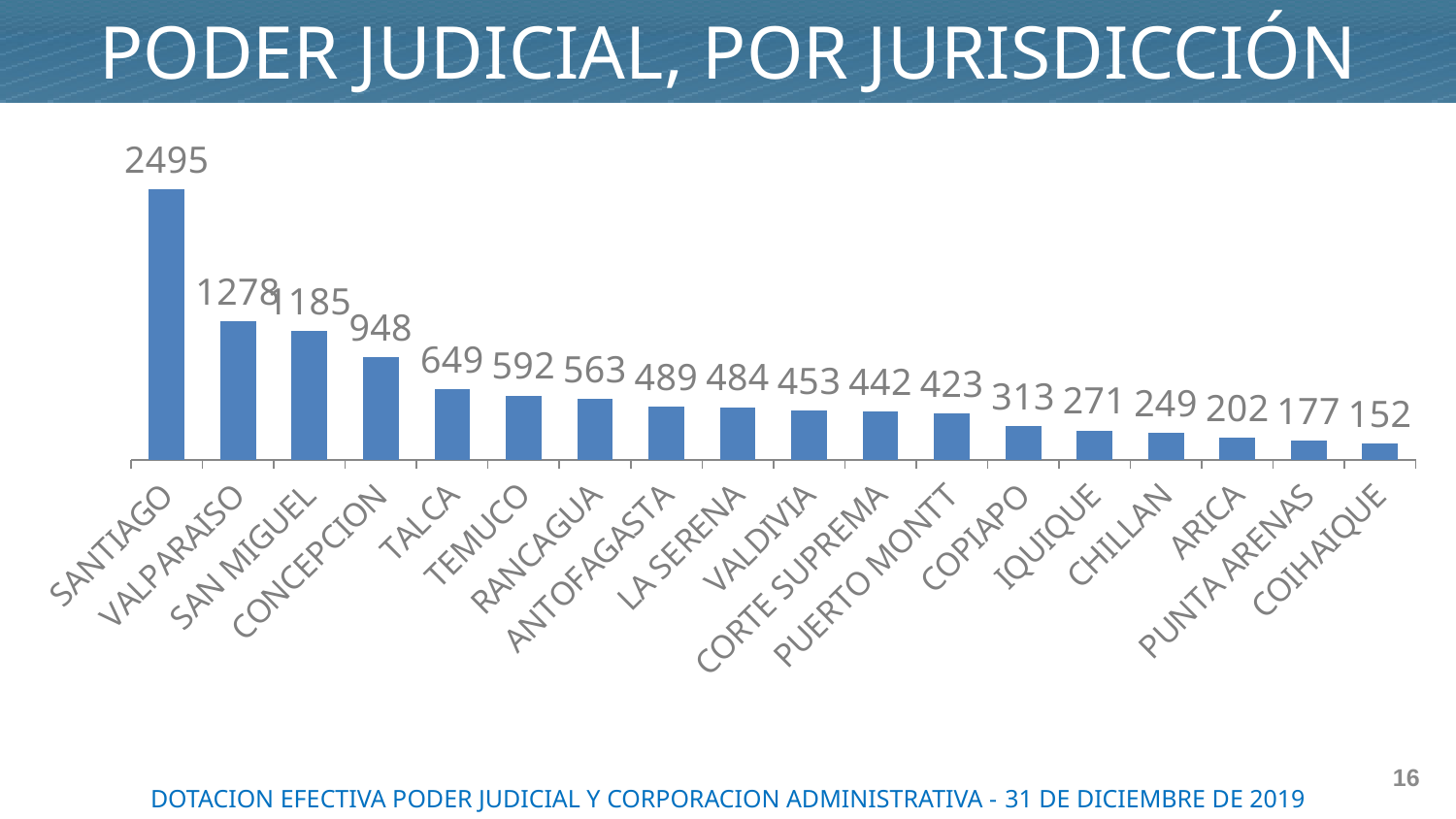
How many jurisdictions are shown in the chart? 18 What is the value for SANTIAGO? 2495 Which jurisdiction has the highest value? SANTIAGO Which jurisdiction has the lowest value? COIHAIQUE What is the difference between the values for TALCA and TEMUCO? 57 What is the value for CONCEPCION? 948 Which has a larger value, COPIAPO or IQUIQUE? COPIAPO What kind of chart is shown on the slide? Bar chart What is the value for COIHAIQUE? 152 Do the values rise or fall from left to right along the x axis? Fall What is the value for CORTE SUPREMA? 442 What is the difference between the values for SANTIAGO and VALPARAISO? 1217